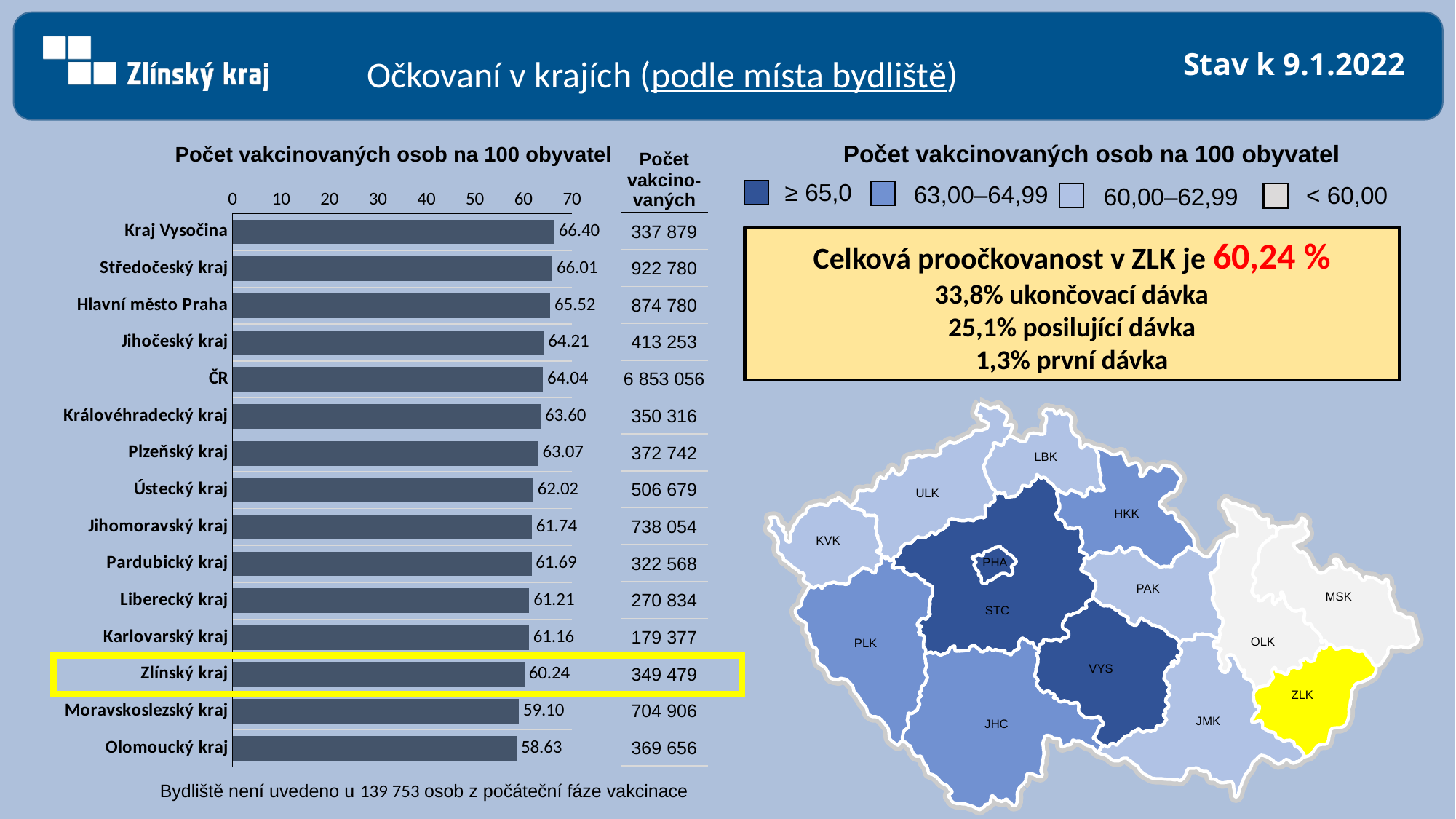
What is the value for ČR in the bar chart? 64.04 How many bars are shown in the bar chart? 15 What is the value for Zlínský kraj in the bar chart? 60.24 What is the difference between the values for Kraj Vysočina and Olomoucký kraj? 7.77 Which category has the highest value in the bar chart? Kraj Vysočina What kind of chart is used to show the number of vaccinated persons per 100 inhabitants by region? bar chart Is the value for Olomoucký kraj greater or less than 60? less Which category has the lowest value in the bar chart? Olomoucký kraj What is the value for Kraj Vysočina in the bar chart? 66.40 What is the difference between the values for ČR and Zlínský kraj? 3.80 Which has a larger value, Plzeňský kraj or Ústecký kraj? Plzeňský kraj What is the title of the bar chart? Počet vakcinovaných osob na 100 obyvatel